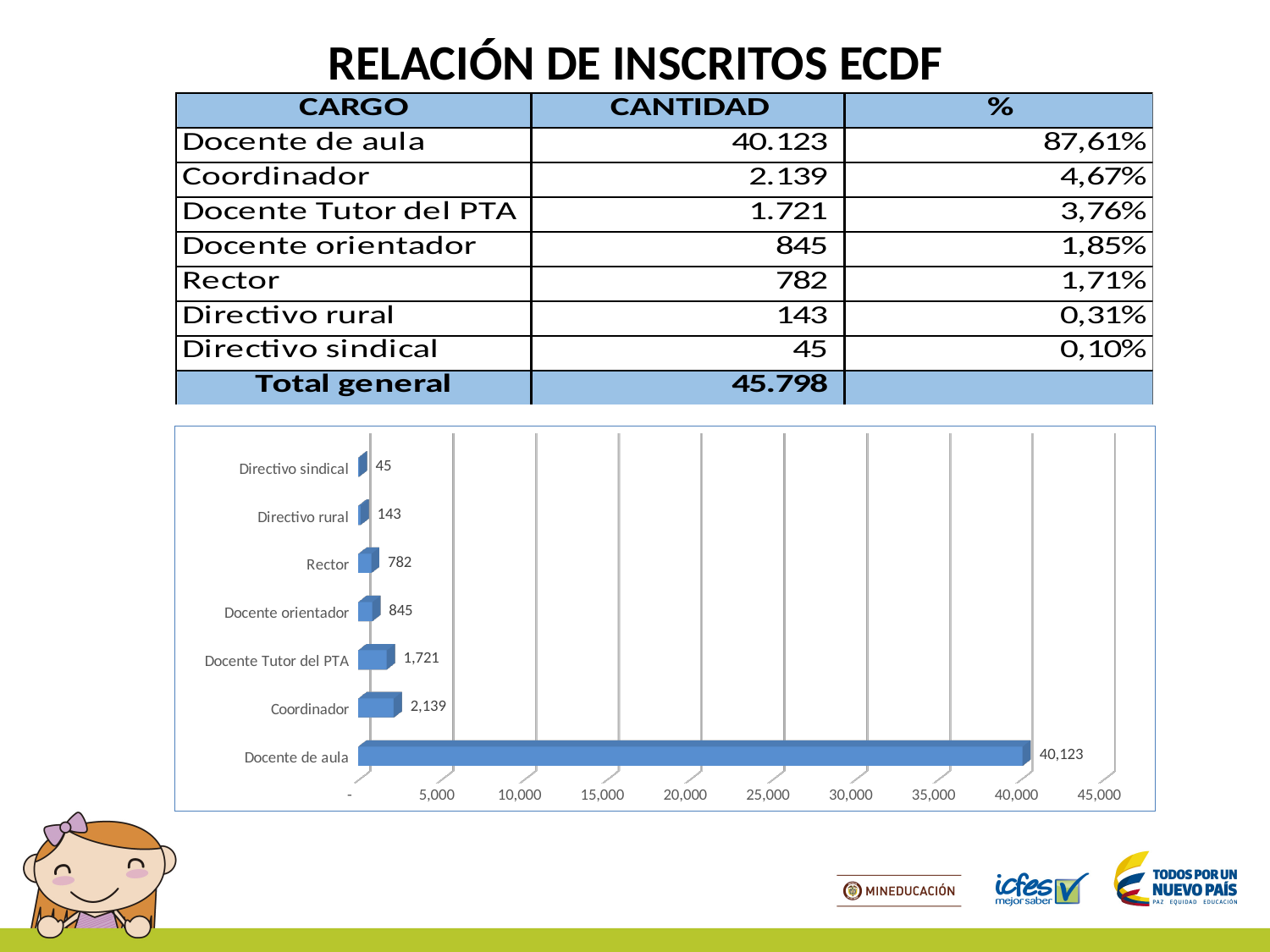
What kind of chart is shown on the slide? bar chart Which category has the lowest value in the bar chart? Directivo sindical What is the value for Docente de aula in the bar chart? 40,123 What is the value for Docente Tutor del PTA in the bar chart? 1,721 What is the difference between the values for Docente orientador and Rector in the bar chart? 63 What is the difference between the values for Directivo rural and Directivo sindical in the bar chart? 98 How many categories are shown in the bar chart? 7 Is the value for Docente de aula in the bar chart greater or less than 35,000? greater What is the value for Coordinador in the bar chart? 2,139 What is the value for Directivo sindical in the bar chart? 45 Which is larger in the bar chart, Coordinador or Docente Tutor del PTA? Coordinador Which category has the highest value in the bar chart? Docente de aula